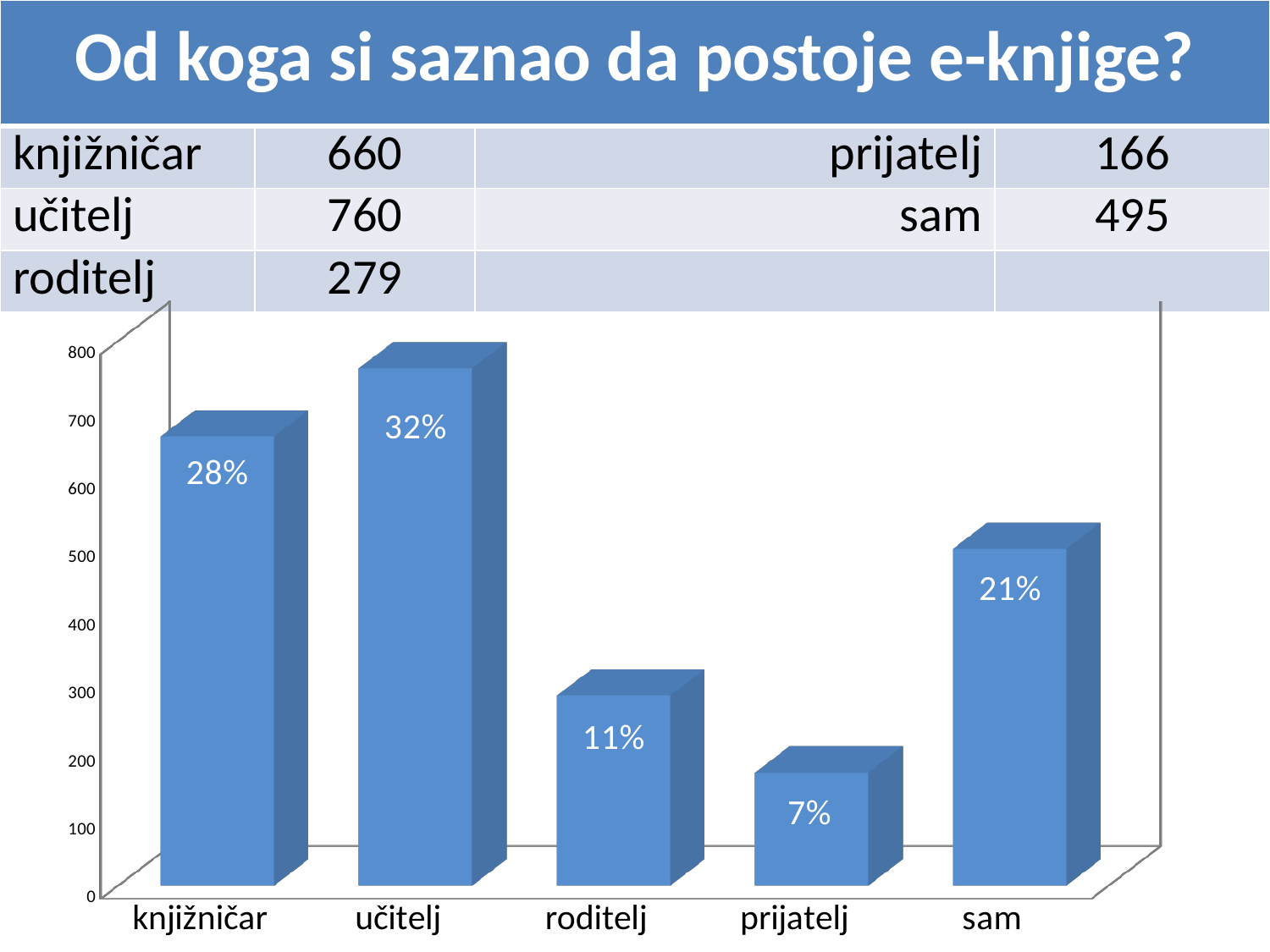
Is the value for učitelj greater or less than 700? greater Which category has the highest bar in the chart? učitelj What percentage label is shown on the bar for knjižničar? 28% What percentage label is shown on the bar for učitelj? 32% What kind of chart is shown on the slide? bar chart How many categories are shown on the x axis of the chart? 5 Which bar is taller, sam or roditelj? sam What is the difference in percentage points between the labels for učitelj and roditelj? 21 Which category has the lowest bar in the chart? prijatelj Is the value for prijatelj greater or less than 200? less What percentage label is shown on the bar for prijatelj? 7% What percentage label is shown on the bar for sam? 21%